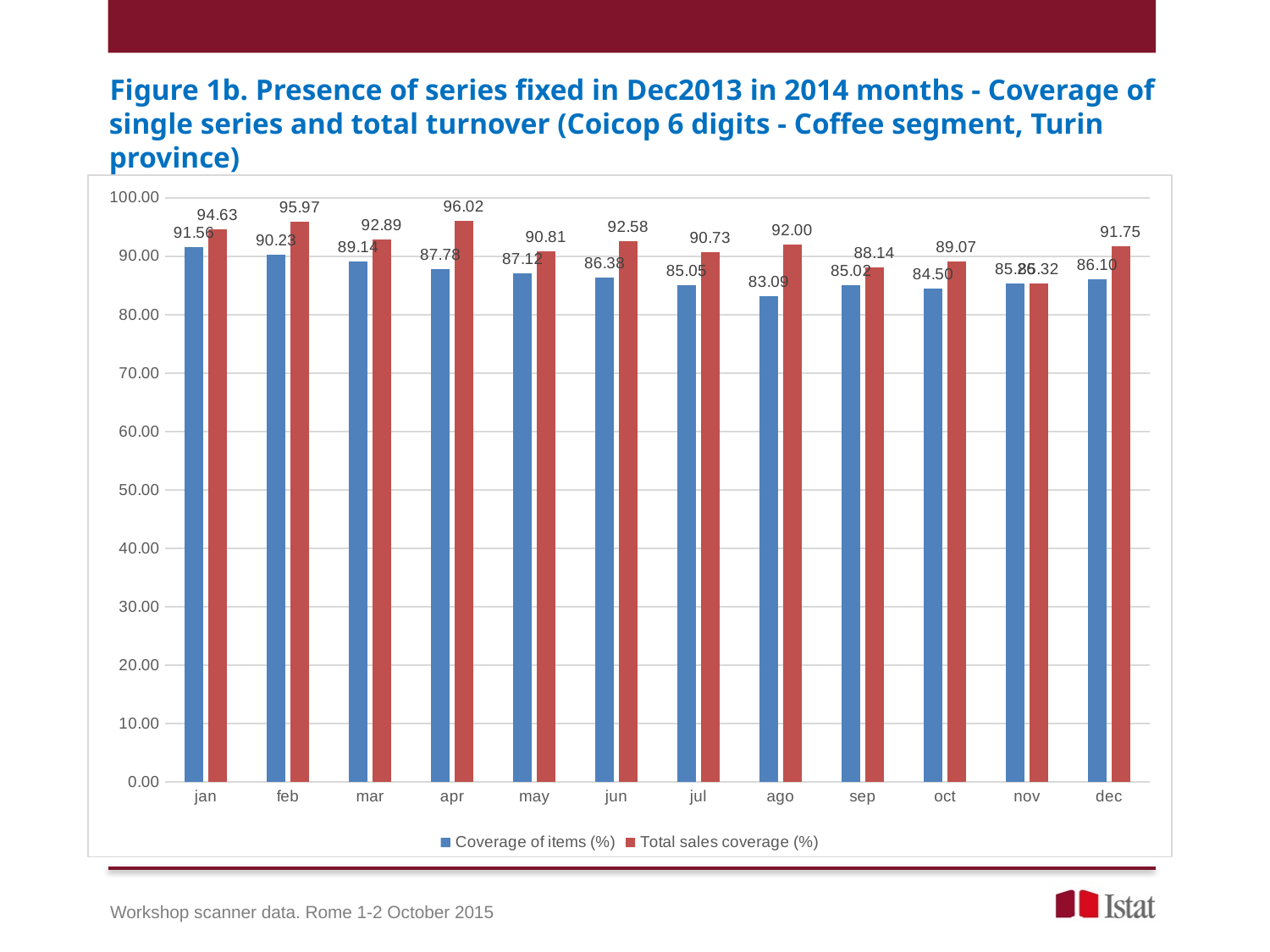
How many months are shown on the x axis? 12 Is the Coverage of items (%) value for jul greater or less than 80.00? greater Which is larger in sep: Coverage of items (%) or Total sales coverage (%)? Total sales coverage (%) What is the difference between Total sales coverage (%) and Coverage of items (%) in jan? 3.07 What is the Coverage of items (%) value for jan? 91.56 What is the Total sales coverage (%) value for apr? 96.02 Which month has the highest Coverage of items (%)? jan What is the Coverage of items (%) value for dec? 86.10 What is the Total sales coverage (%) value for ago? 92.00 How many series does the legend list? 2 What is the difference between Total sales coverage (%) and Coverage of items (%) in ago? 8.91 Which month has the lowest Coverage of items (%)? ago